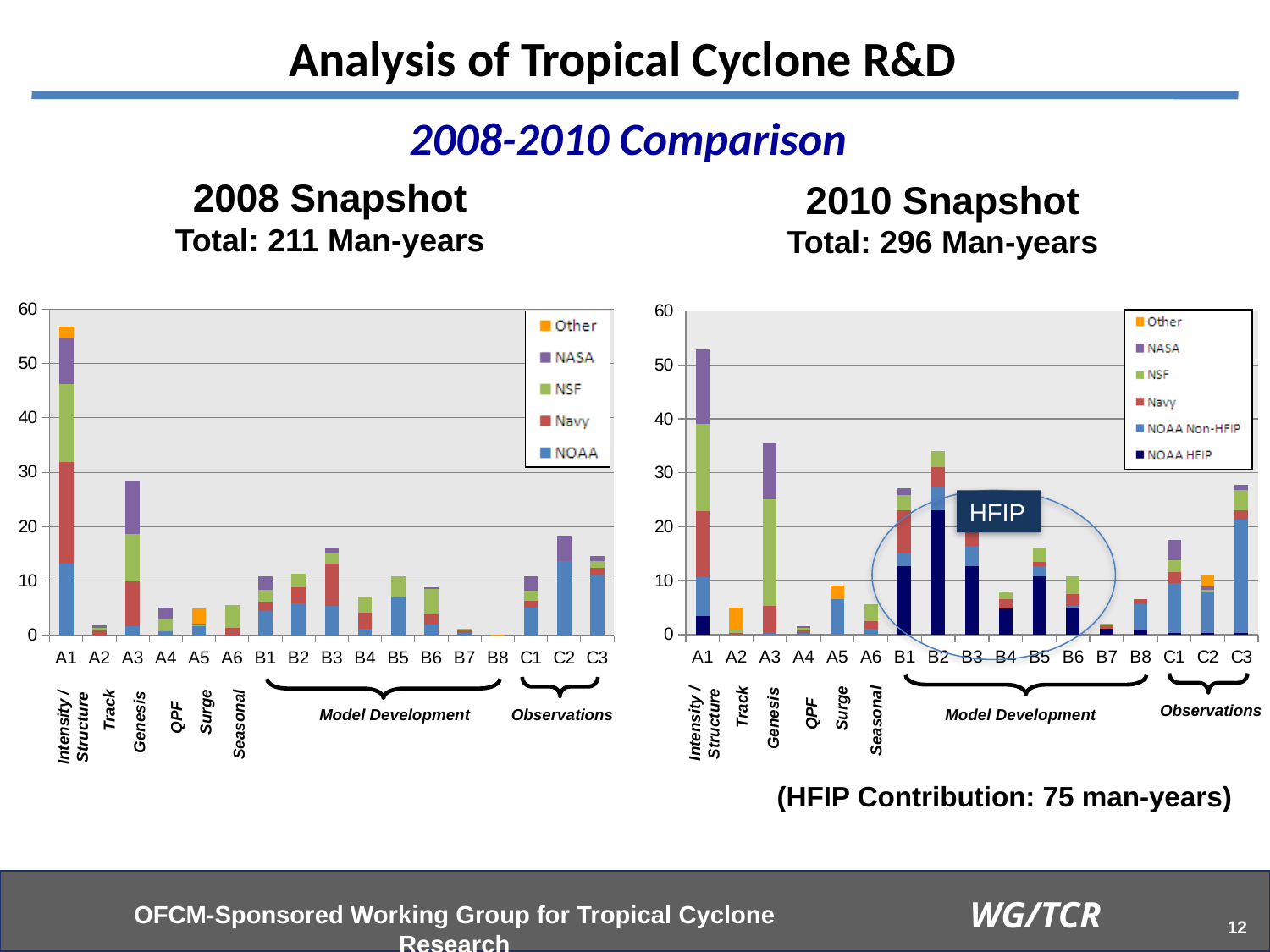
In the 2008 Snapshot chart, which has the larger total bar, A3 or C2? A3 How many series does the legend of the 2008 Snapshot chart list? 5 In the 2010 Snapshot chart, which series appears at the bottom of each stacked bar? NOAA HFIP In the 2010 Snapshot chart, which category has the tallest stacked bar? A1 How many series does the legend of the 2010 Snapshot chart list? 6 In the 2008 Snapshot chart, is the total value for A1 greater or less than 50? greater In the 2010 Snapshot chart, is the total value for B2 greater or less than 30? greater In the 2008 Snapshot chart, which category has the tallest stacked bar? A1 In the 2010 Snapshot chart, is the total value for A4 greater or less than 10? less In the 2008 Snapshot chart, which category has the shortest stacked bar? B8 What kind of chart is the 2008 Snapshot chart? stacked bar chart How many categories are shown on the x axis of the 2010 Snapshot chart? 17